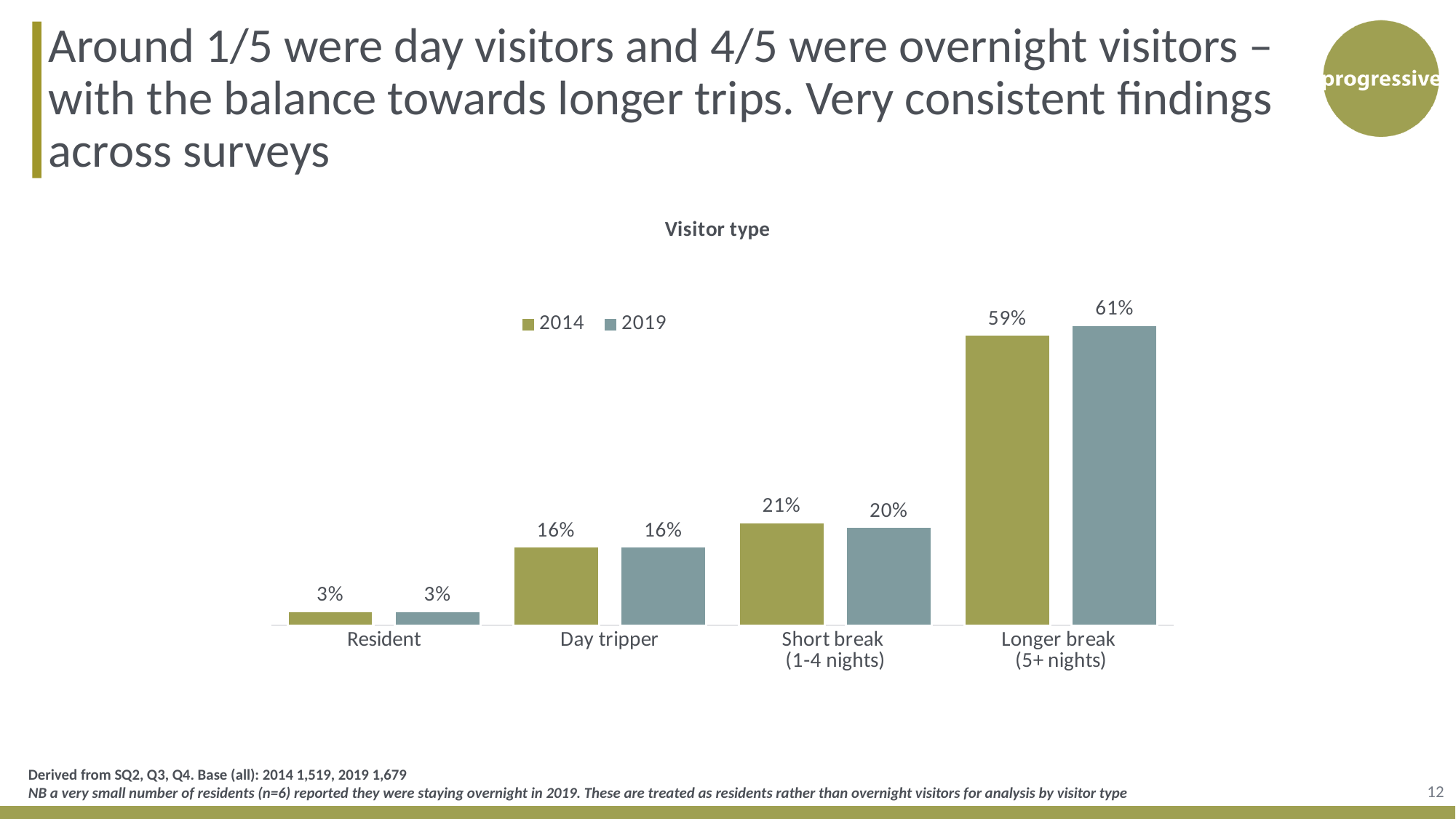
What kind of chart is shown on the slide? Bar chart What is the difference between the 2019 and 2014 values for Longer break (5+ nights)? 2% Which visitor type has the highest value in 2019? Longer break (5+ nights) What is the 2019 value for Longer break (5+ nights)? 61% Which visitor type has the lowest value in 2014? Resident Which is larger for Short break (1-4 nights): the 2014 value or the 2019 value? 2014 How many visitor type categories are shown on the x axis? 4 How many series does the legend list? 2 What is the title of the chart? Visitor type What is the 2014 value for Short break (1-4 nights)? 21% What is the 2019 value for Resident? 3% What is the 2014 value for Day tripper? 16%